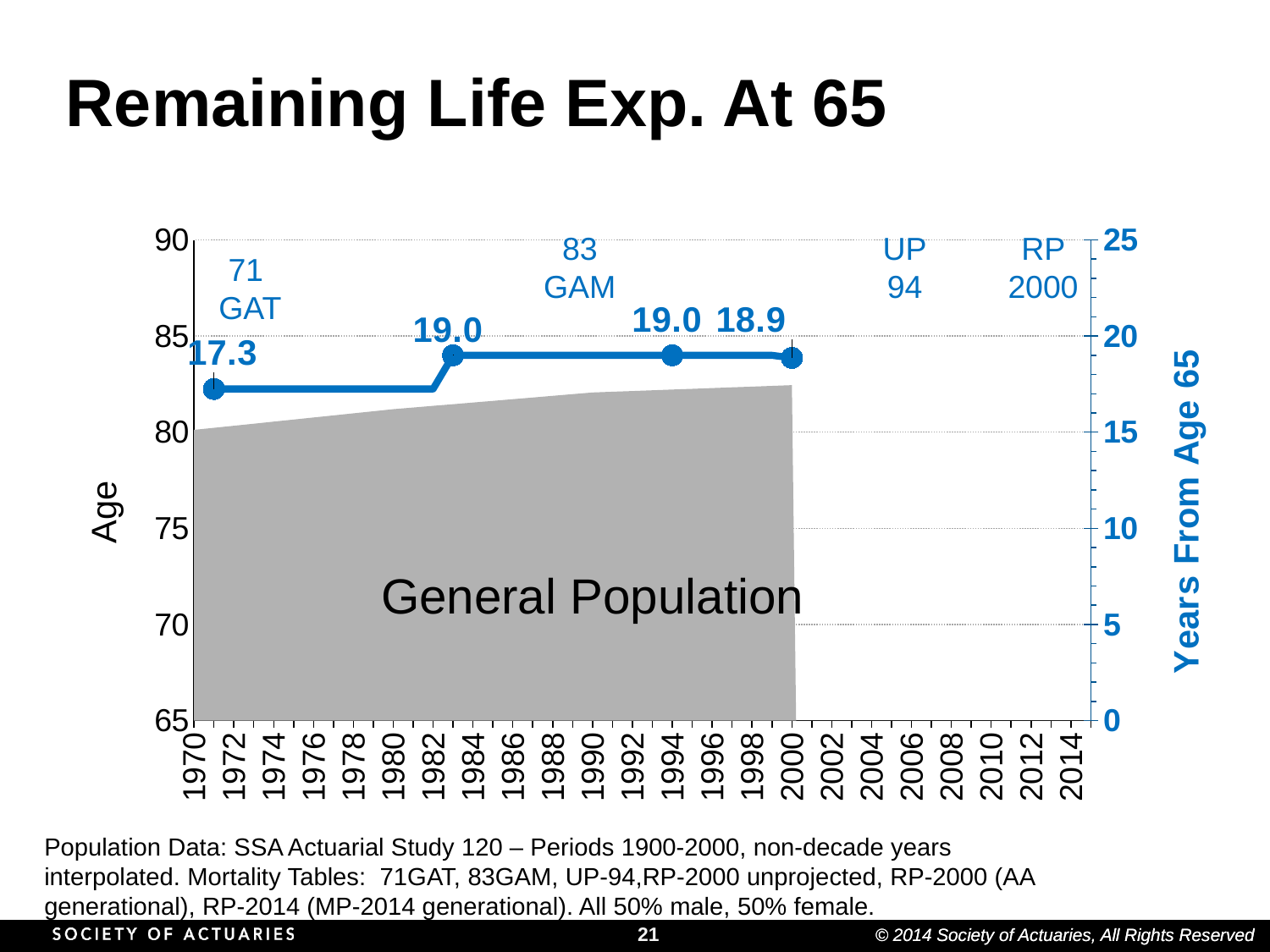
What value is labelled on the line for the RP 2000 table? 18.9 What is the label of the right-hand vertical axis? Years From Age 65 On the left Age axis, is the General Population value in 1970 greater or less than 85? less What is the difference between the labelled values for 83 GAM and 71 GAT? 1.7 How many labelled data points are on the blue line? 4 Which mortality table has the lowest labelled value on the line? 71 GAT What value is labelled on the line for the 83 GAM table? 19.0 What kind of chart is the blue series with the labelled values? line chart Does the General Population area rise or fall from 1970 to 2000? rise What is the remaining life expectancy value labelled for the 71 GAT table? 17.3 Which has the larger labelled value, 71 GAT or RP 2000? RP 2000 What is the difference between the labelled values for UP 94 and RP 2000? 0.1